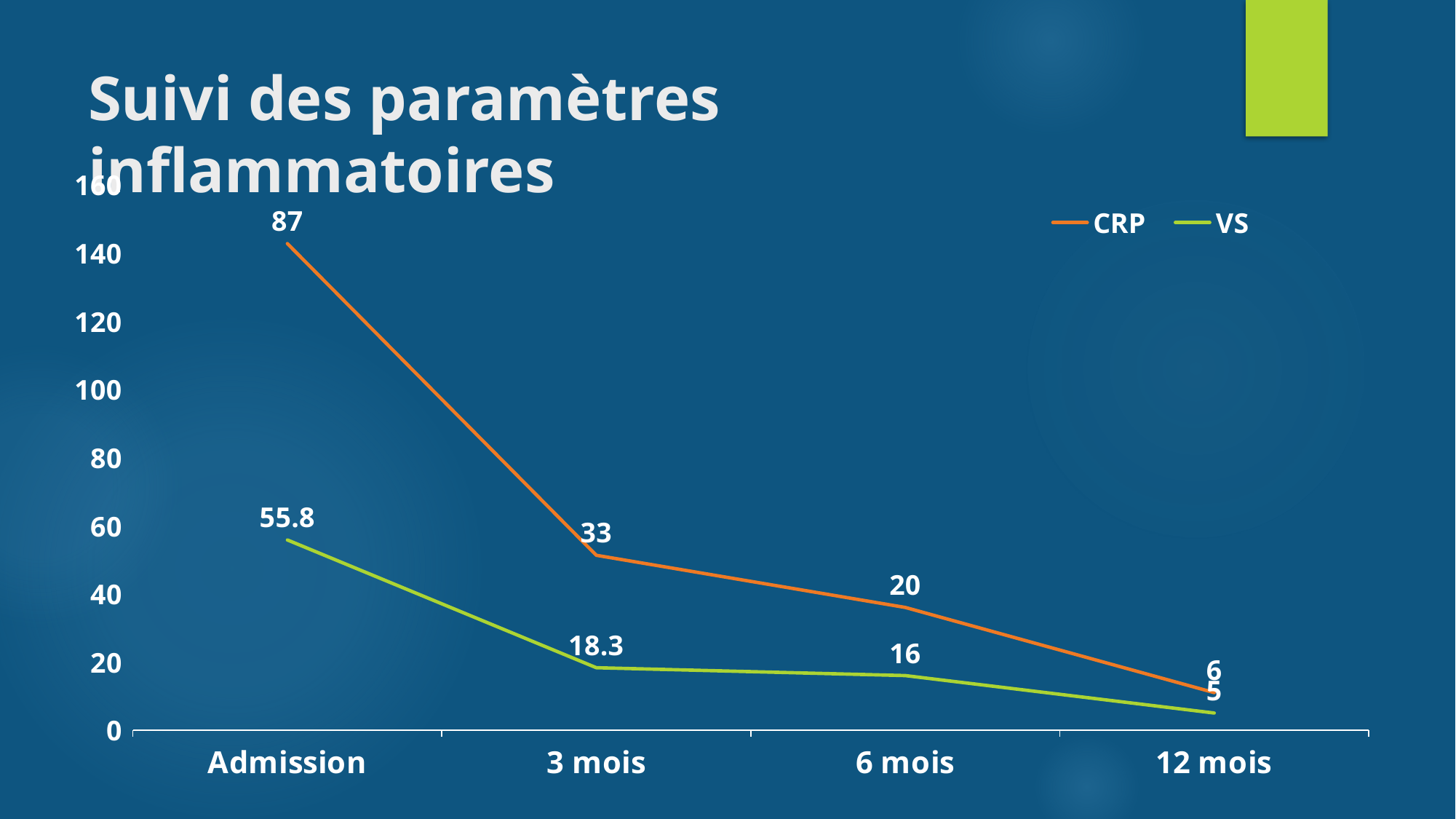
What kind of chart is shown on the slide? Line chart What is the difference between the CRP value at Admission and at 3 mois? 54 Which is larger at 6 mois, CRP or VS? CRP How many series does the legend list? 2 What is the VS value at 3 mois? 18.3 At which time point is the VS value lowest? 12 mois How many time points are shown on the x axis? 4 What is the CRP value at 6 mois? 20 What is the VS value at 12 mois? 5 Do the VS values rise or fall from Admission to 12 mois? Fall At which time point is the CRP value highest? Admission What is the CRP value at Admission? 87